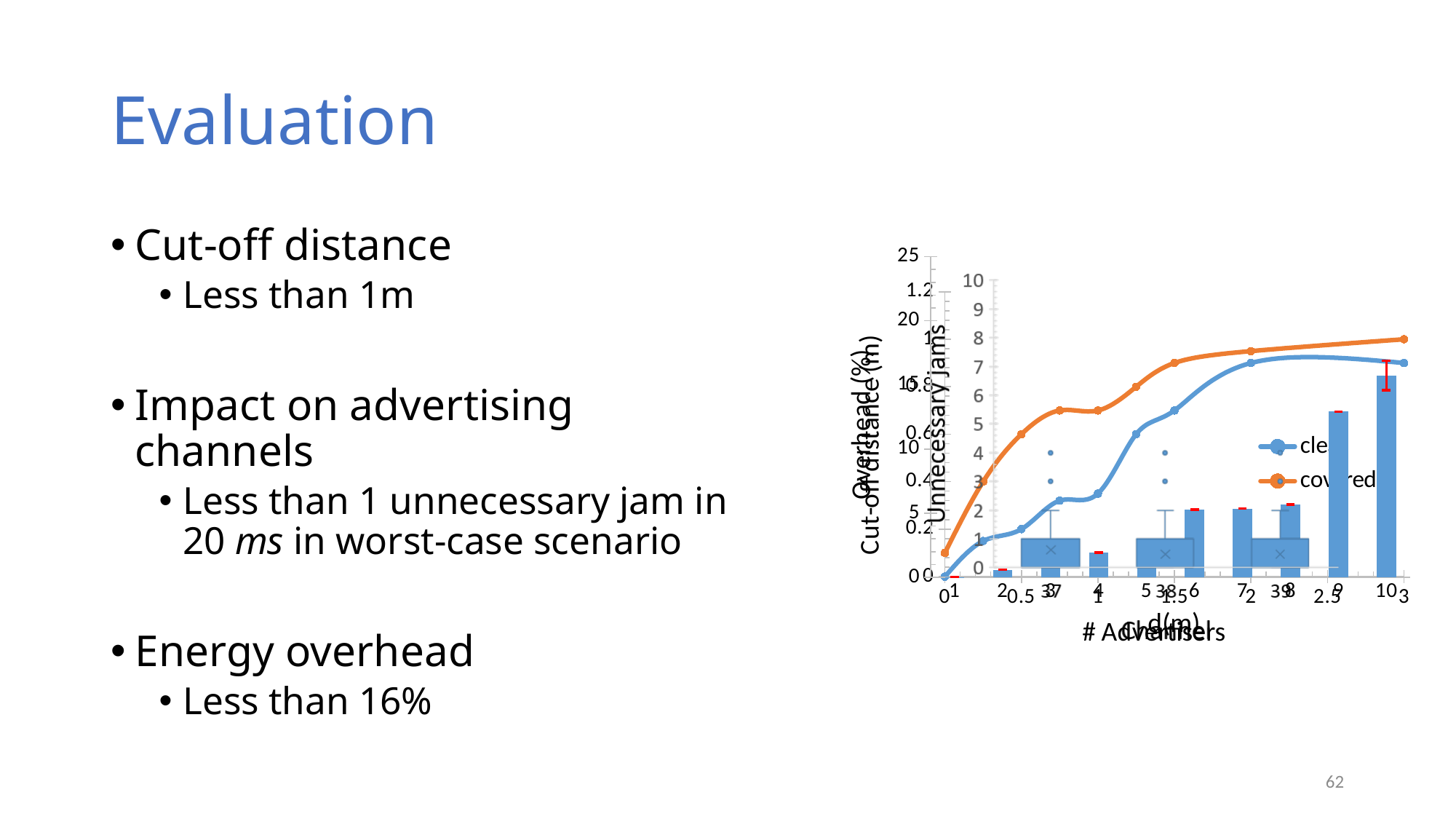
In the line chart plotted against d(m), is the clear value at d = 2 greater or less than 0.8? greater In the line chart plotted against d(m), which series is higher at d = 3, clear or covered? covered In the Overhead (%) chart plotted against # Advertisers, which number of advertisers has the highest overhead? 10 In the Overhead (%) chart plotted against # Advertisers, which number of advertisers has the lowest overhead? 1 In the Overhead (%) chart plotted against # Advertisers, what kind of chart is used? bar chart In the line chart plotted against d(m), how many series does the legend list? 2 In the line chart plotted against d(m), do the clear and covered values rise or fall as d increases? rise In the Overhead (%) chart plotted against # Advertisers, is the overhead for 6 advertisers greater or less than 10? less In the line chart plotted against d(m), is the covered value at d = 1 greater or less than 0.6? greater In the line chart plotted against d(m), which series is drawn in orange? covered In the Unnecessary jams chart plotted against Channels, how many channels are shown on the x axis? 3